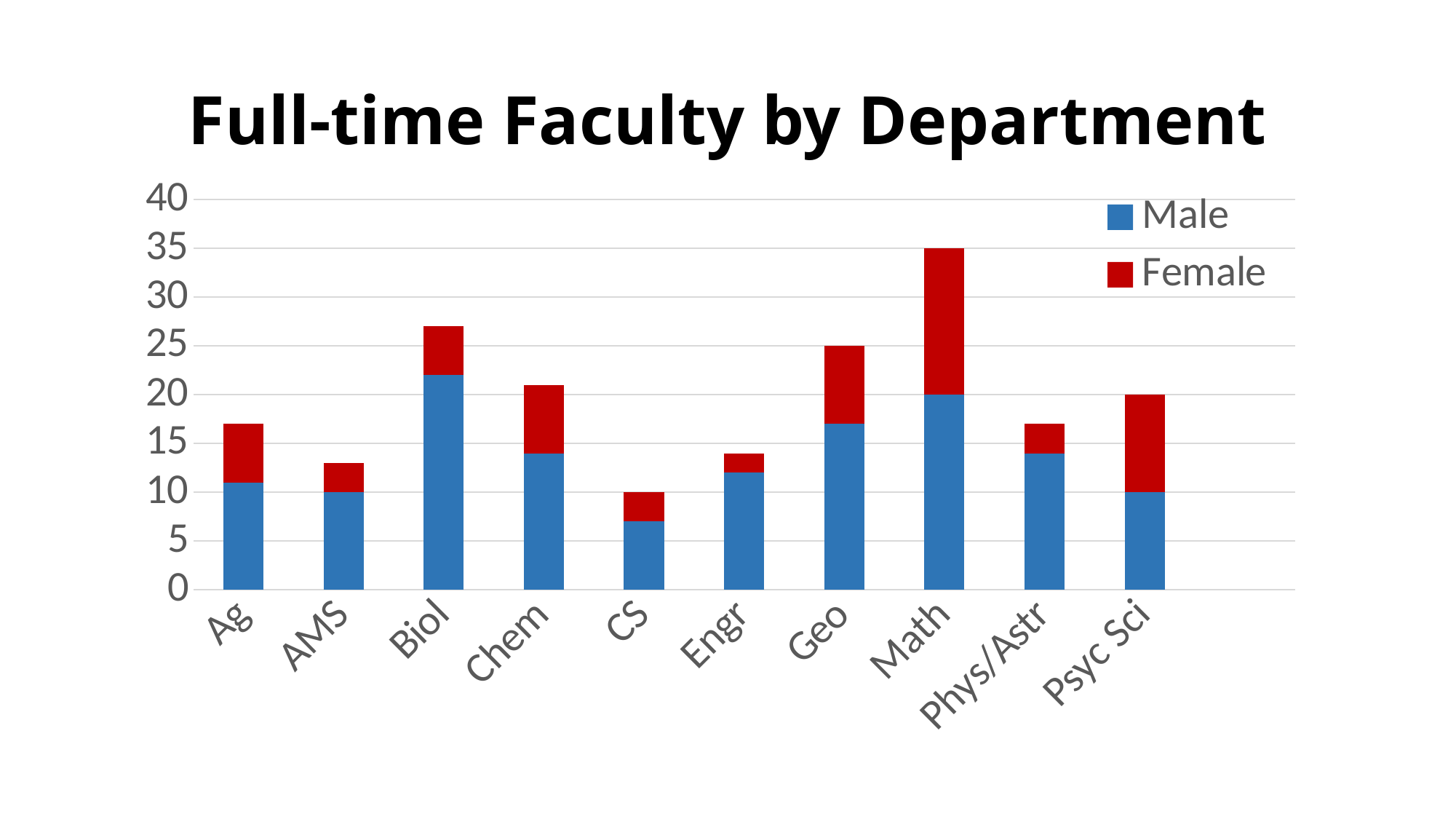
What is the total full-time faculty for Geo? 25 What is the Male value for Math? 20 Is the total for Biol greater or less than 25? greater Which department has the lowest total full-time faculty? CS Which is larger, the Female value for Math or the Female value for Biol? Math How many series does the legend list? 2 What is the total full-time faculty for Math? 35 What kind of chart is shown on the slide? bar chart Is the total for Engr greater or less than 15? less How many departments are shown on the x axis? 10 Which department has the highest total full-time faculty? Math What colour represents the Female series in the legend? red